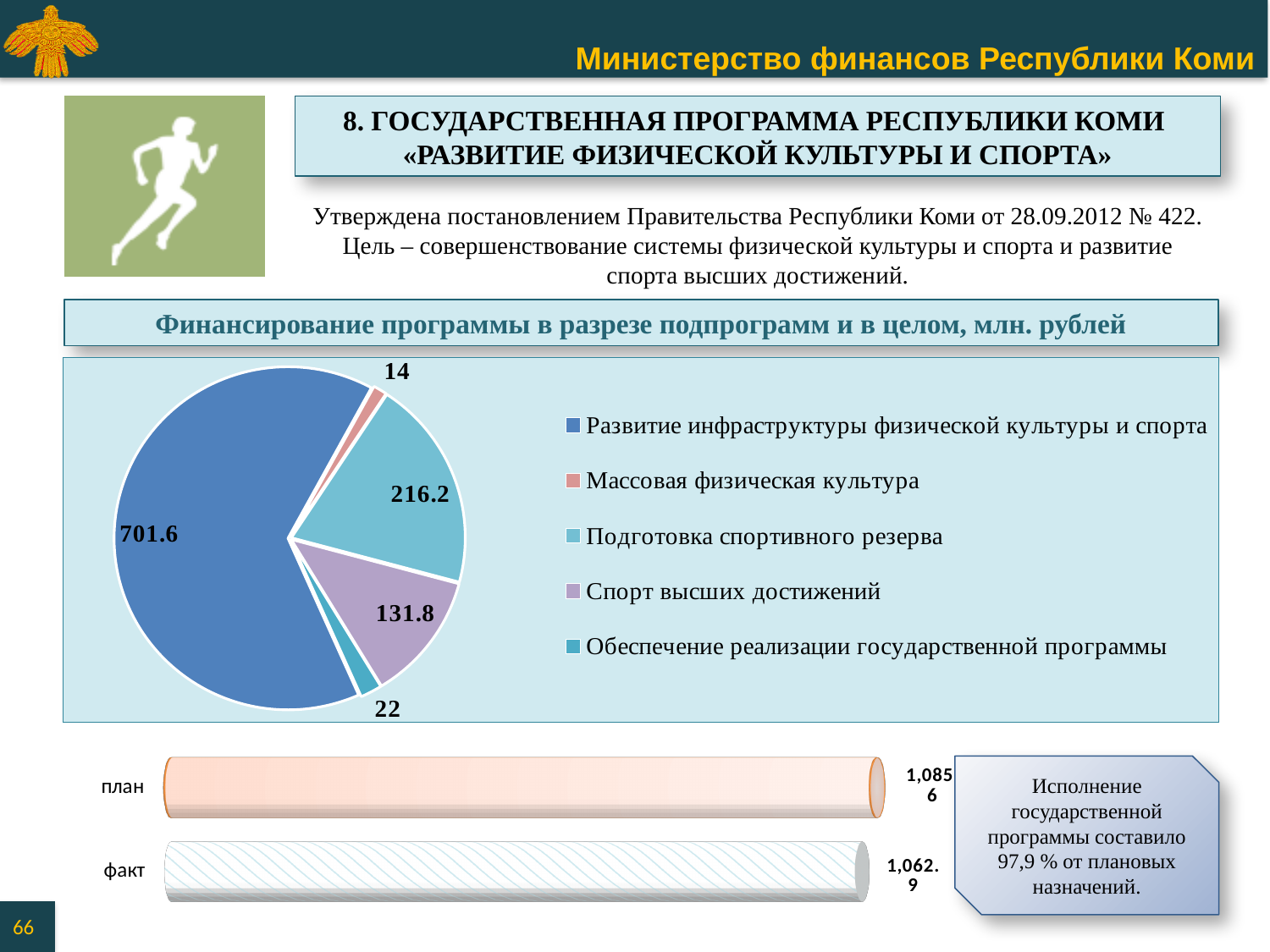
What kind of chart is the lower chart comparing план and факт? bar chart In the lower bar chart, which bar is longer: «план» or «факт»? план In the pie chart, what is the difference between «Подготовка спортивного резерва» and «Спорт высших достижений»? 84.4 In the pie chart, which is larger: «Обеспечение реализации государственной программы» or «Массовая физическая культура»? Обеспечение реализации государственной программы In the pie chart, which subprogramme has the smallest slice? Массовая физическая культура In the pie chart, what is the value for «Подготовка спортивного резерва»? 216.2 In the pie chart, how many slices (subprogrammes) are shown? 5 In the pie chart, what is the value for «Развитие инфраструктуры физической культуры и спорта»? 701.6 In the pie chart, what is the value for «Спорт высших достижений»? 131.8 In the pie chart, which subprogramme has the largest slice? Развитие инфраструктуры физической культуры и спорта What kind of chart is the upper chart showing programme financing by subprogramme? pie chart In the lower bar chart, what is the value for «факт»? 1,062.9